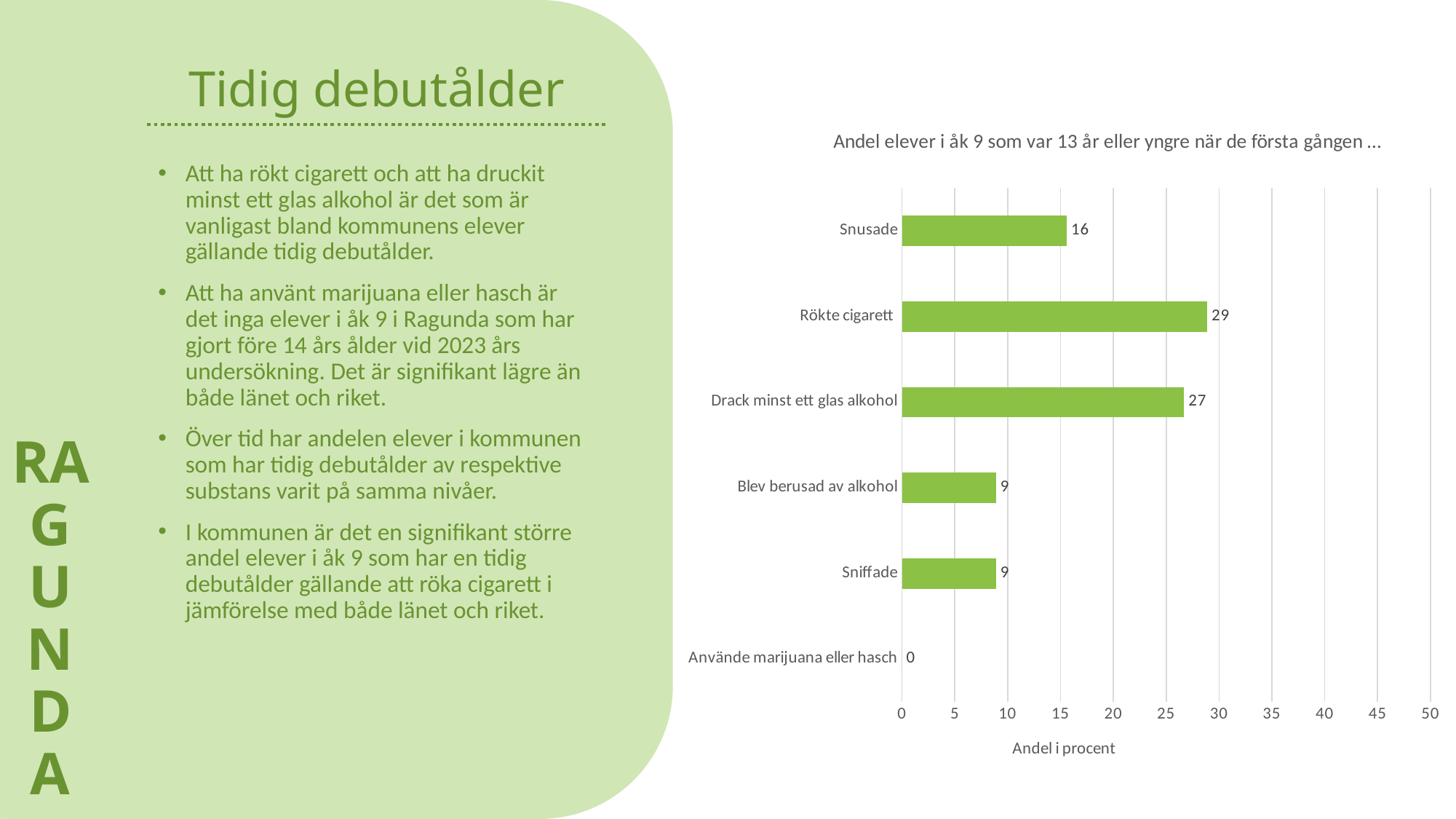
What is the value for Snusade? 16 How many categories are shown in the chart? 6 What is the value for Rökte cigarett? 29 What is the label of the horizontal axis? Andel i procent Which is larger, the value for Snusade or the value for Blev berusad av alkohol? Snusade What is the value for Drack minst ett glas alkohol? 27 What is the value for Använde marijuana eller hasch? 0 What is the difference between the values for Rökte cigarett and Snusade? 13 Which category has the highest value? Rökte cigarett Is the value for Drack minst ett glas alkohol greater or less than 20? greater Which category has the lowest value? Använde marijuana eller hasch What kind of chart is shown on the slide? bar chart